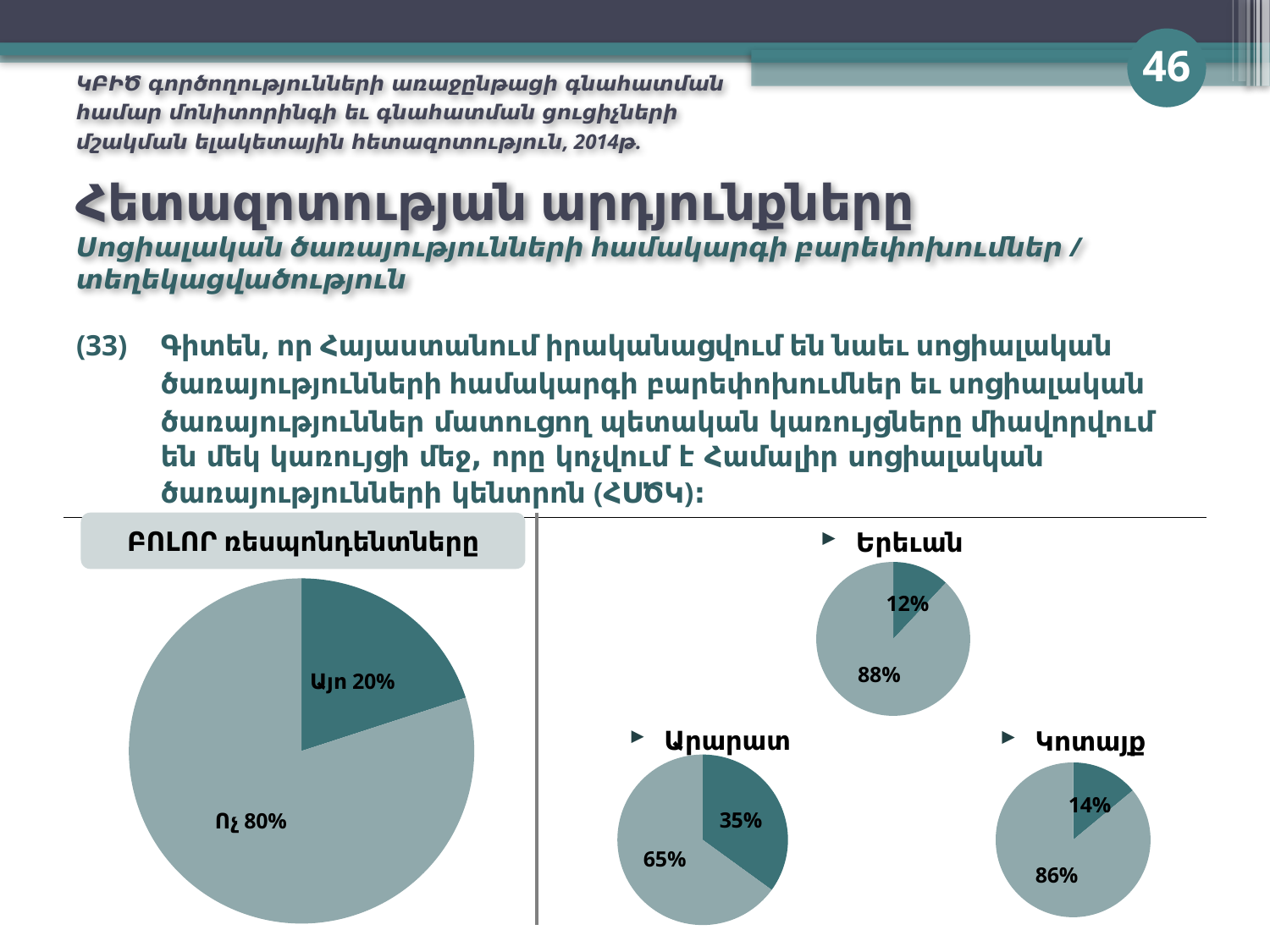
In the 'Երևան' pie chart, what is the larger slice's value? 88% Which regional pie chart ('Երևան', 'Արարատ' or 'Կոտայք') has the smallest dark-coloured slice? Երևան What type of chart is used for 'ԲՈԼՈՐ ռեսպոնդենտները'? Pie chart How many pie charts are shown on the slide? 4 In the 'Արարատ' pie chart, what is the value of the dark-coloured slice? 35% In the 'ԲՈԼՈՐ ռեսպոնդենտները' pie chart, what share is labelled 'Ոչ'? 80% Which regional pie chart ('Երևան', 'Արարատ' or 'Կոտայք') has the largest dark-coloured slice? Արարատ In the 'Կոտայք' pie chart, what is the value of the larger slice? 86% Is the smaller slice in the 'Կոտայք' pie chart larger or smaller than the smaller slice in the 'Երևան' pie chart? Larger In the 'ԲՈԼՈՐ ռեսպոնդենտները' pie chart, what is the difference between the 'Ոչ' and 'Այո' shares? 60% In the 'ԲՈԼՈՐ ռեսպոնդենտները' pie chart, what share is labelled 'Այո'? 20% In the 'Երևան' pie chart, what is the smaller slice's value? 12%